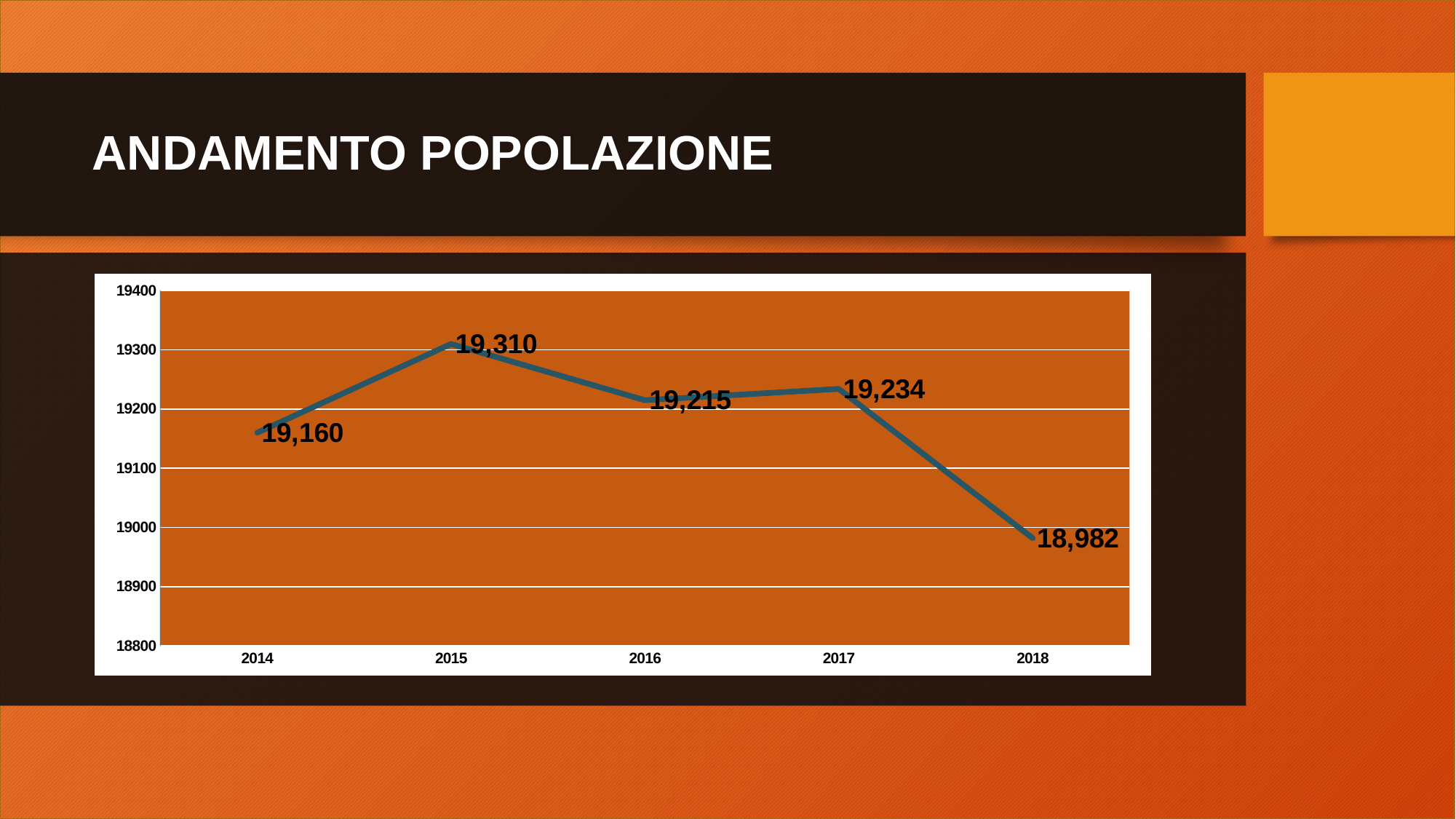
Which is larger, the value for 2014 or the value for 2016? 2016 Is the value for 2018 greater or less than 19000? less What is the population value shown for 2018? 18,982 Which year has the lowest population value? 2018 What is the difference between the 2017 value and the 2016 value? 19 Does the population rise or fall from 2017 to 2018? fall How many years are plotted on the chart? 5 What is the difference between the 2015 value and the 2018 value? 328 What is the population value shown for 2014? 19,160 What is the population value shown for 2016? 19,215 What kind of chart is shown on the slide? line chart Which year has the highest population value? 2015